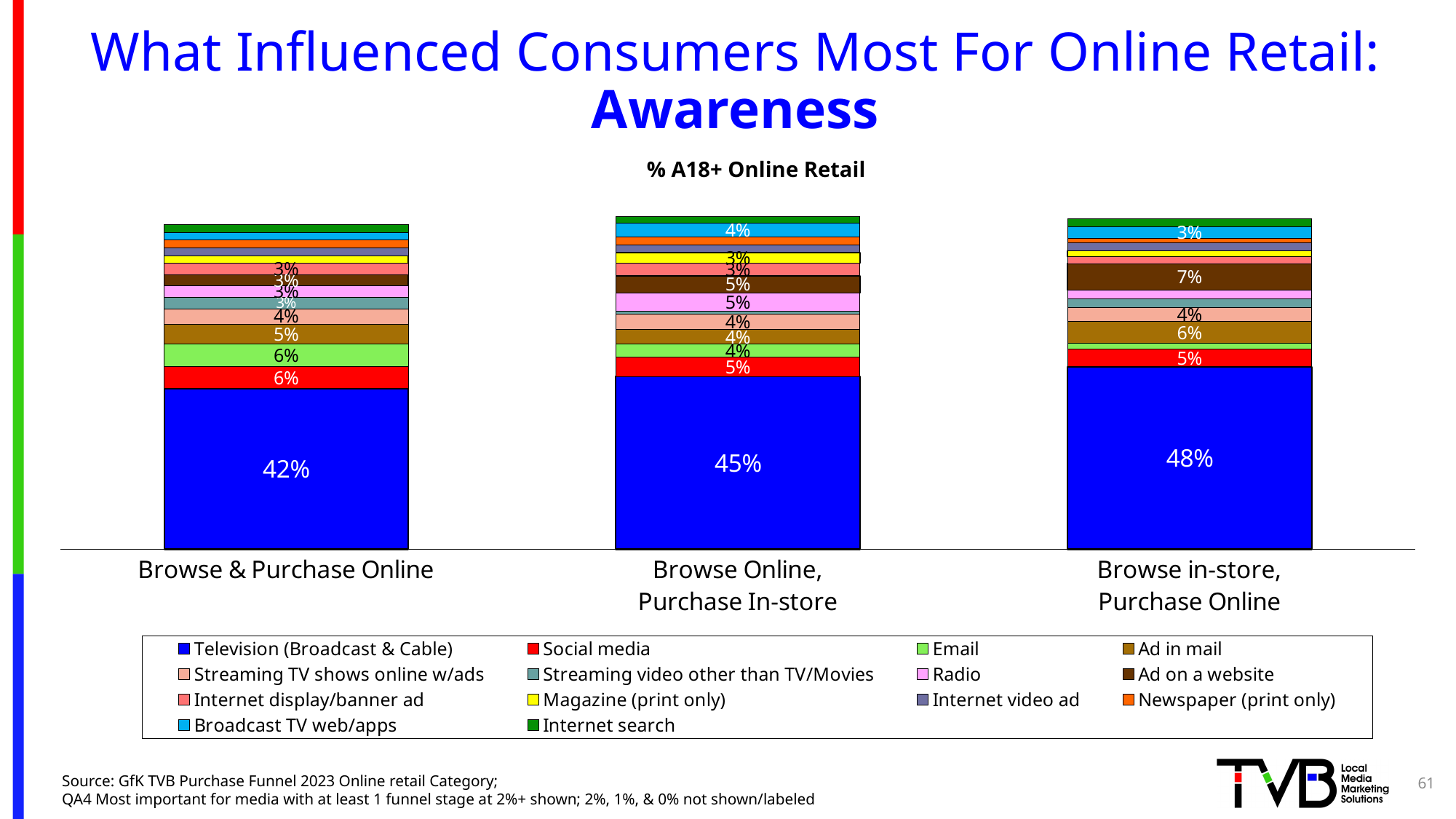
How many series does the legend list? 14 What is the difference in the Television (Broadcast & Cable) value between Browse in-store, Purchase Online and Browse & Purchase Online? 6 percentage points What is the title printed above the chart? % A18+ Online Retail What kind of chart is shown on the slide? Stacked bar chart Which has the larger Social media value: Browse & Purchase Online or Browse in-store, Purchase Online? Browse & Purchase Online What is the Television (Broadcast & Cable) value for Browse in-store, Purchase Online? 48% How many categories are shown on the x axis? 3 What is the Radio value for Browse Online, Purchase In-store? 5% What is the Television (Broadcast & Cable) value for Browse & Purchase Online? 42% Which category has the highest Television (Broadcast & Cable) value? Browse in-store, Purchase Online What is the Email value for Browse & Purchase Online? 6% What is the Ad on a website value for Browse in-store, Purchase Online? 7%